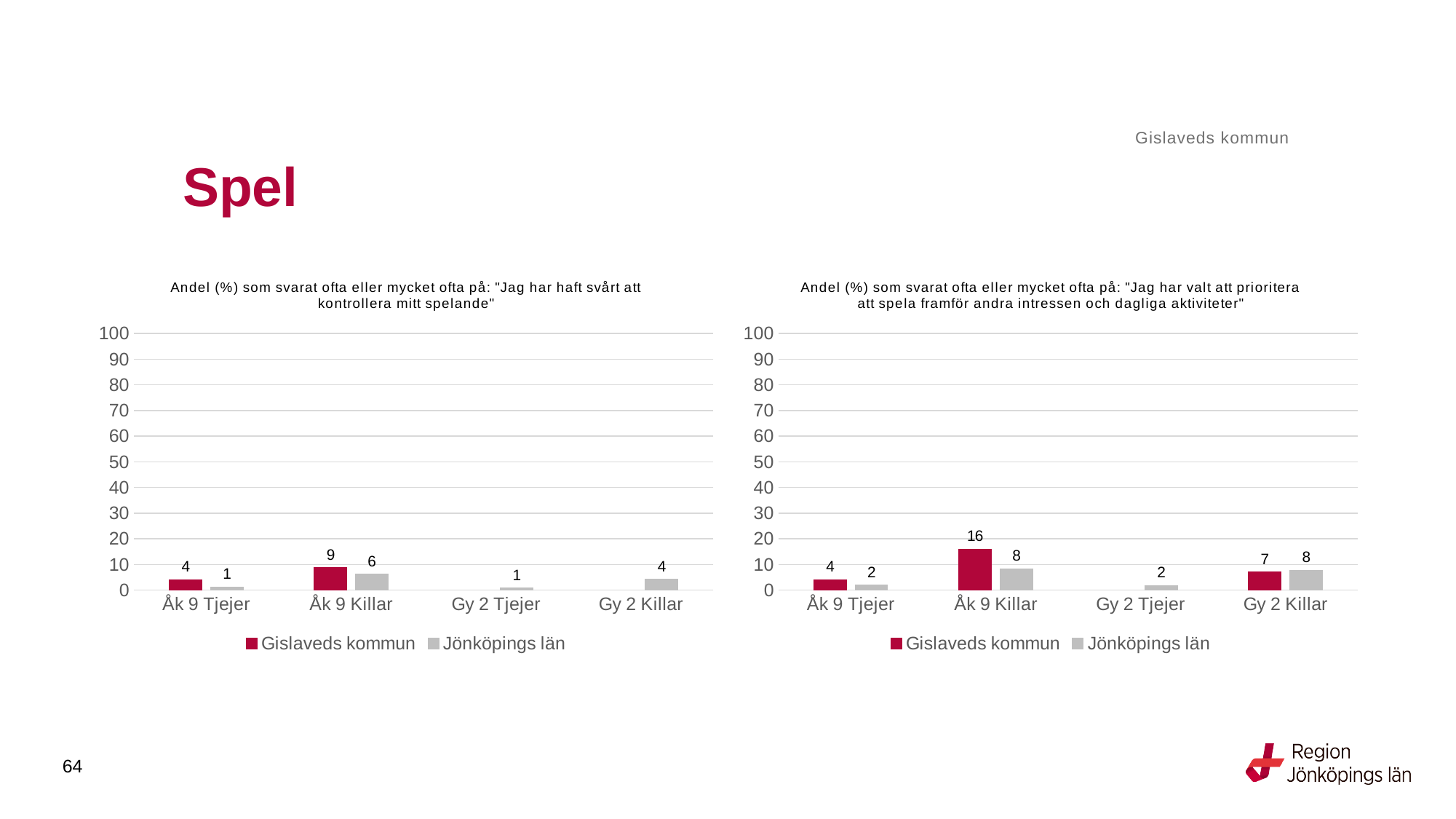
In the right chart, what is the difference between Gislaveds kommun and Jönköpings län for Åk 9 Killar? 8 In the left chart, what is the value for Gislaveds kommun for Åk 9 Killar? 9 How many series does the legend of the right chart list? 2 In the left chart, what is the difference between Gislaveds kommun and Jönköpings län for Åk 9 Tjejer? 3 In the left chart, which category has the lowest value for Jönköpings län? Åk 9 Tjejer and Gy 2 Tjejer (both 1) In the right chart, which is larger for Gy 2 Killar: Gislaveds kommun or Jönköpings län? Jönköpings län In the right chart, what is the value for Gislaveds kommun for Åk 9 Killar? 16 In the right chart, what is the value for Jönköpings län for Gy 2 Tjejer? 2 What kind of chart is the left chart? Bar chart In the right chart, which category has the highest value for Gislaveds kommun? Åk 9 Killar How many categories are shown on the x axis of the left chart? 4 In the left chart, what is the value for Jönköpings län for Gy 2 Killar? 4